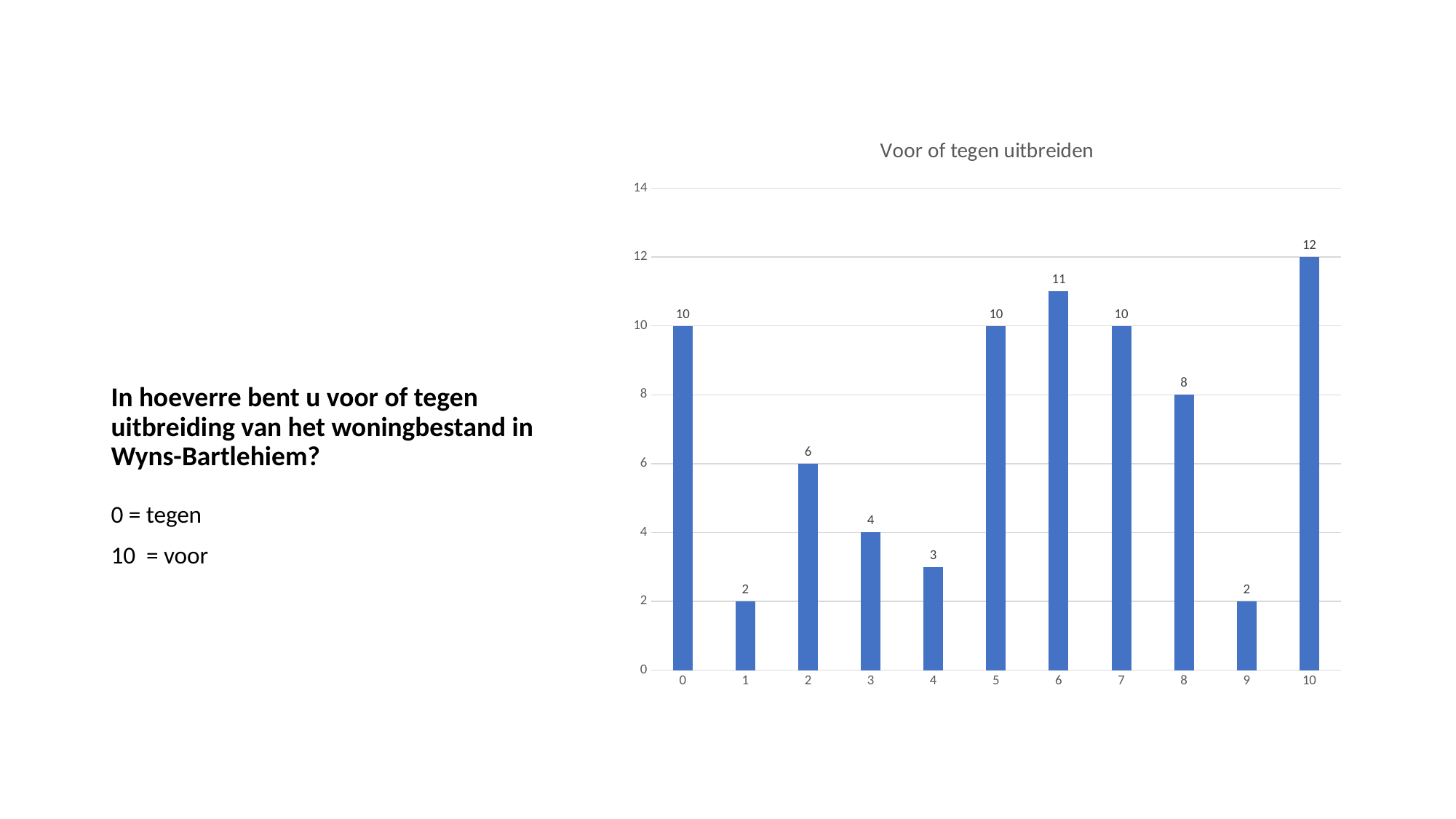
How many categories are shown on the x axis? 11 What is the title of the chart? Voor of tegen uitbreiden What is the value for category 10? 12 Which categories share the lowest value of 2? 1 and 9 What is the difference between the values for category 10 and category 8? 4 What is the difference between the values for category 6 and category 5? 1 What is the value for category 6? 11 Which is larger, the value for category 2 or the value for category 4? category 2 Which category has the highest value? 10 What is the value for category 3? 4 What is the value for category 0? 10 What kind of chart is shown? bar chart